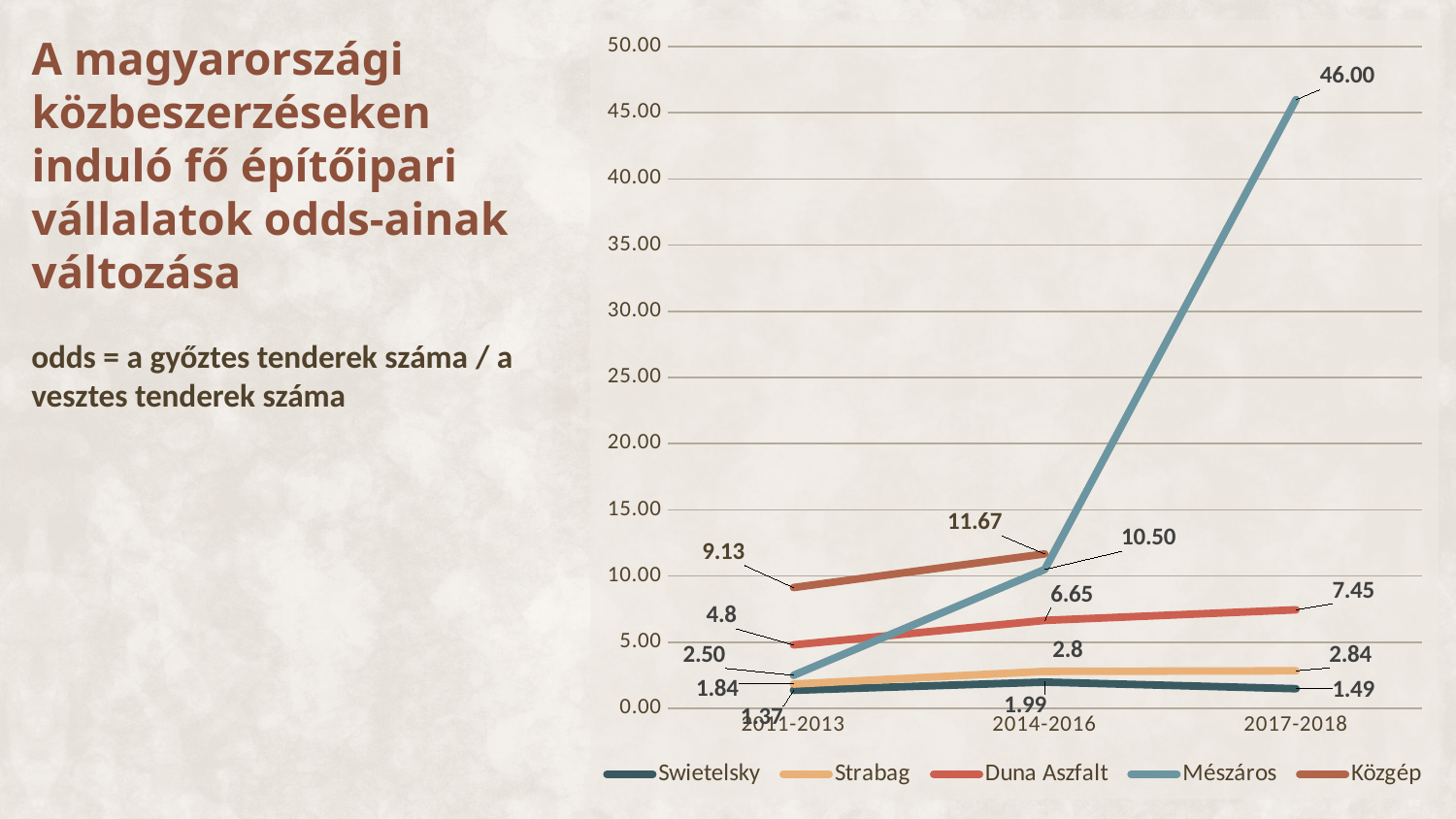
How many periods are shown on the x axis? 3 What is the value for Közgép in 2011-2013? 9.13 Which series has the highest value in 2011-2013? Közgép Which series has the lowest value in 2017-2018? Swietelsky What is the value for Strabag in 2017-2018? 2.84 What is the value for Mészáros in 2017-2018? 46.00 In 2014-2016, which is larger: the value for Közgép or the value for Mészáros? Közgép Which series has the highest value in 2017-2018? Mészáros How many series does the legend list? 5 What is the value for Duna Aszfalt in 2014-2016? 6.65 What kind of chart is shown on the slide? Line chart By how much did the value for Mészáros increase from 2014-2016 to 2017-2018? 35.50